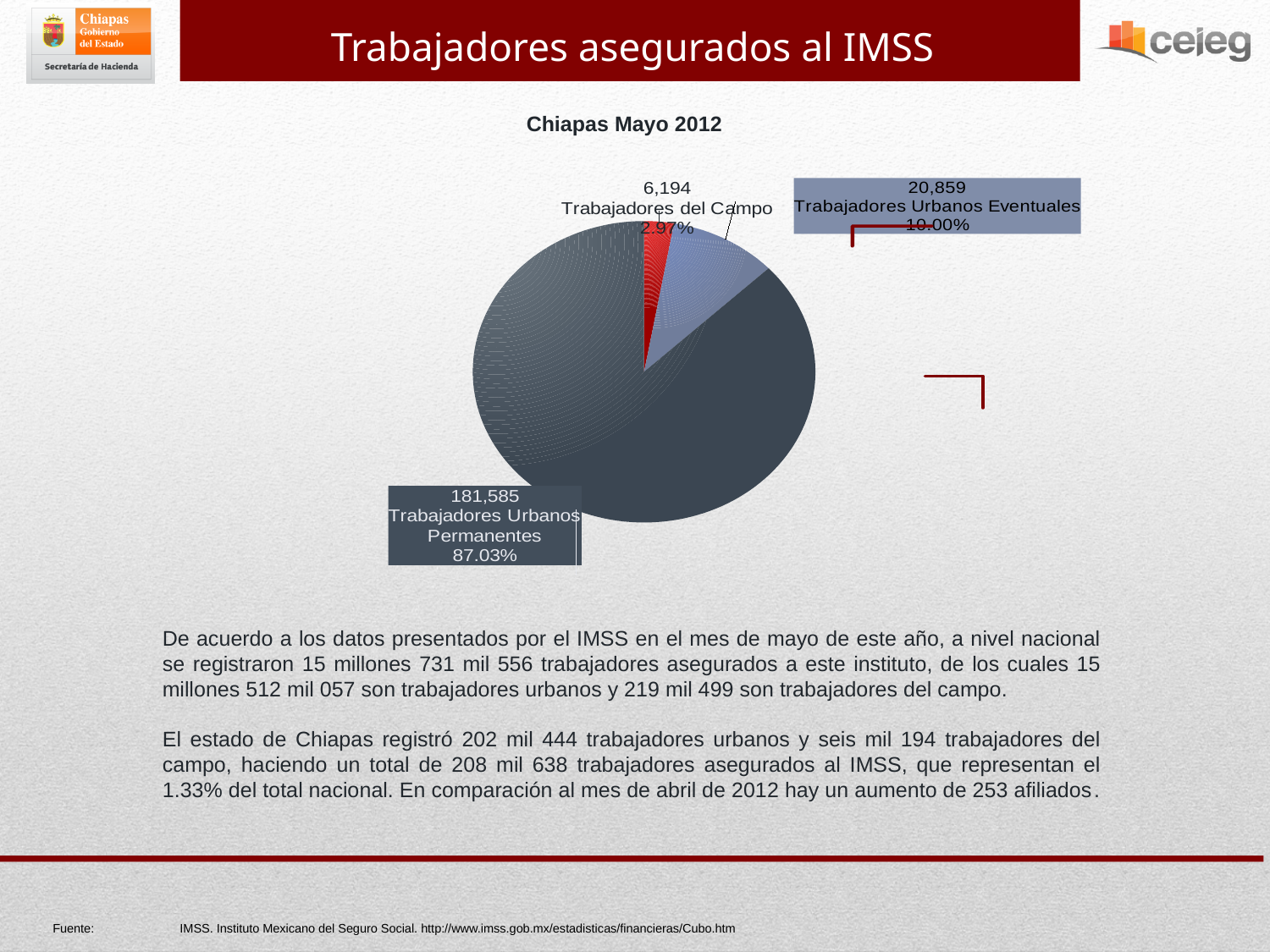
Which category has the smallest slice of the pie? Trabajadores del Campo What share of the pie does Trabajadores del Campo represent? 2.97% What is the value for Trabajadores Urbanos Eventuales? 20,859 What is the value for Trabajadores Urbanos Permanentes? 181,585 How many slices does the pie chart have? 3 What is the title of the chart? Chiapas Mayo 2012 What is the difference between the values for Trabajadores Urbanos Eventuales and Trabajadores del Campo? 14,665 What type of chart is shown on the slide? pie chart What is the value for Trabajadores del Campo? 6,194 Which is larger, the value for Trabajadores Urbanos Eventuales or Trabajadores del Campo? Trabajadores Urbanos Eventuales Which category has the largest slice of the pie? Trabajadores Urbanos Permanentes What share of the pie does Trabajadores Urbanos Permanentes represent? 87.03%